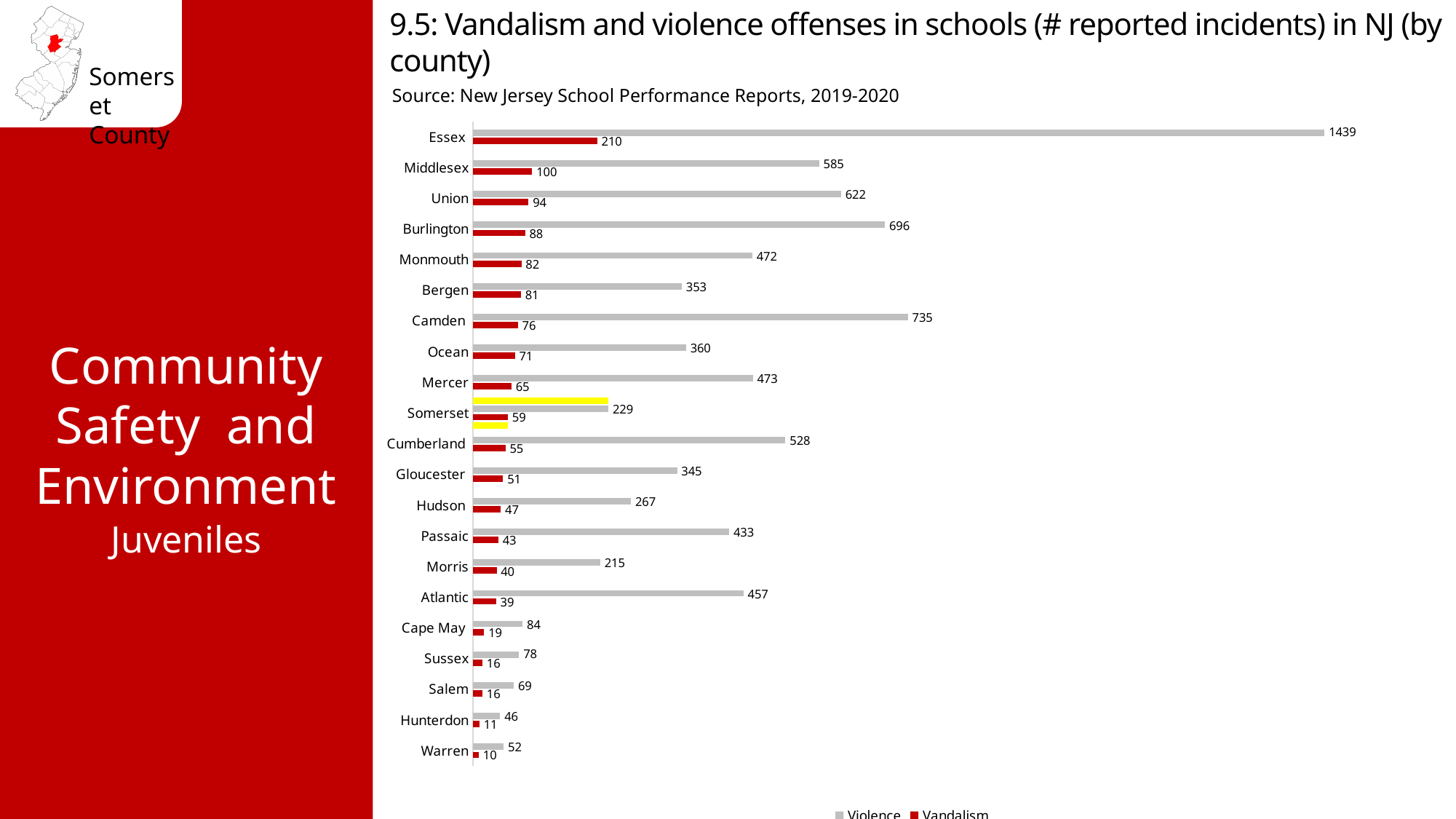
How many series does the legend list? 2 How many counties are listed on the chart? 21 How many reported violence incidents are shown for Somerset County? 229 What is the difference between the vandalism values for Somerset and Cumberland? 4 Which has a higher violence value, Camden or Burlington? Camden What type of chart is shown on the slide? Bar chart Which county has the lowest violence value? Hunterdon Which county has the highest number of reported violence incidents? Essex What is the violence value for Cumberland? 528 What is the difference between the violence values for Essex and Middlesex? 854 Which county has the lowest vandalism value? Warren What is the vandalism value for Camden? 76